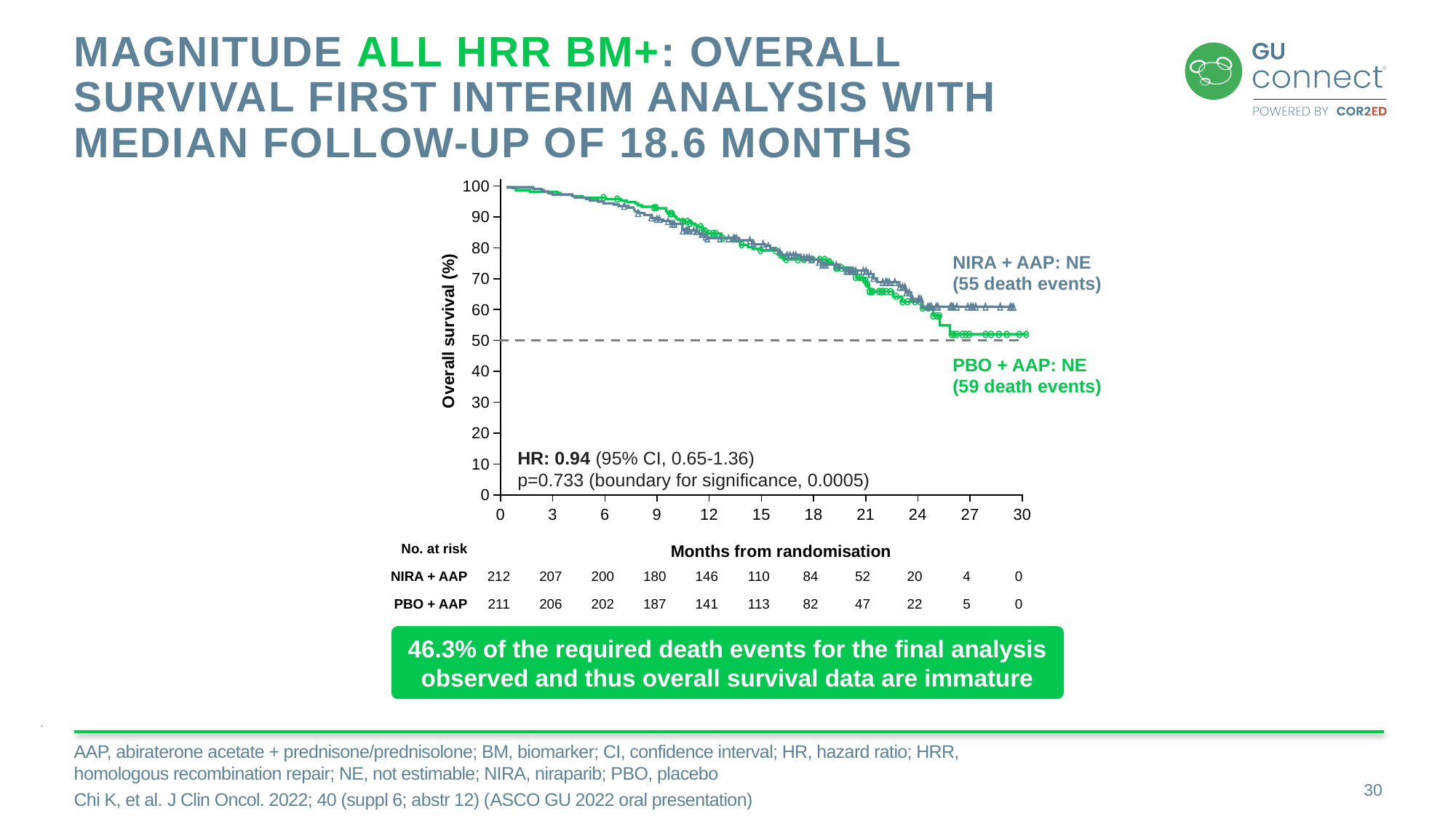
What is the label of the x axis? Months from randomisation How many treatment arms (series) are plotted on the chart? 2 What kind of chart is shown on the slide? line chart (Kaplan-Meier survival curve) What is the difference in death events between the PBO + AAP arm and the NIRA + AAP arm? 4 How many patients were at risk in the PBO + AAP arm at 9 months? 187 What is the label of the y axis? Overall survival (%) How many death events were observed in the NIRA + AAP arm? 55 At 21 months, which arm had more patients at risk, NIRA + AAP or PBO + AAP? NIRA + AAP How many patients were at risk in the NIRA + AAP arm at 12 months? 146 Do the overall survival curves rise or fall as months from randomisation increase? fall How many death events were observed in the PBO + AAP arm? 59 What is the hazard ratio shown on the chart? 0.94